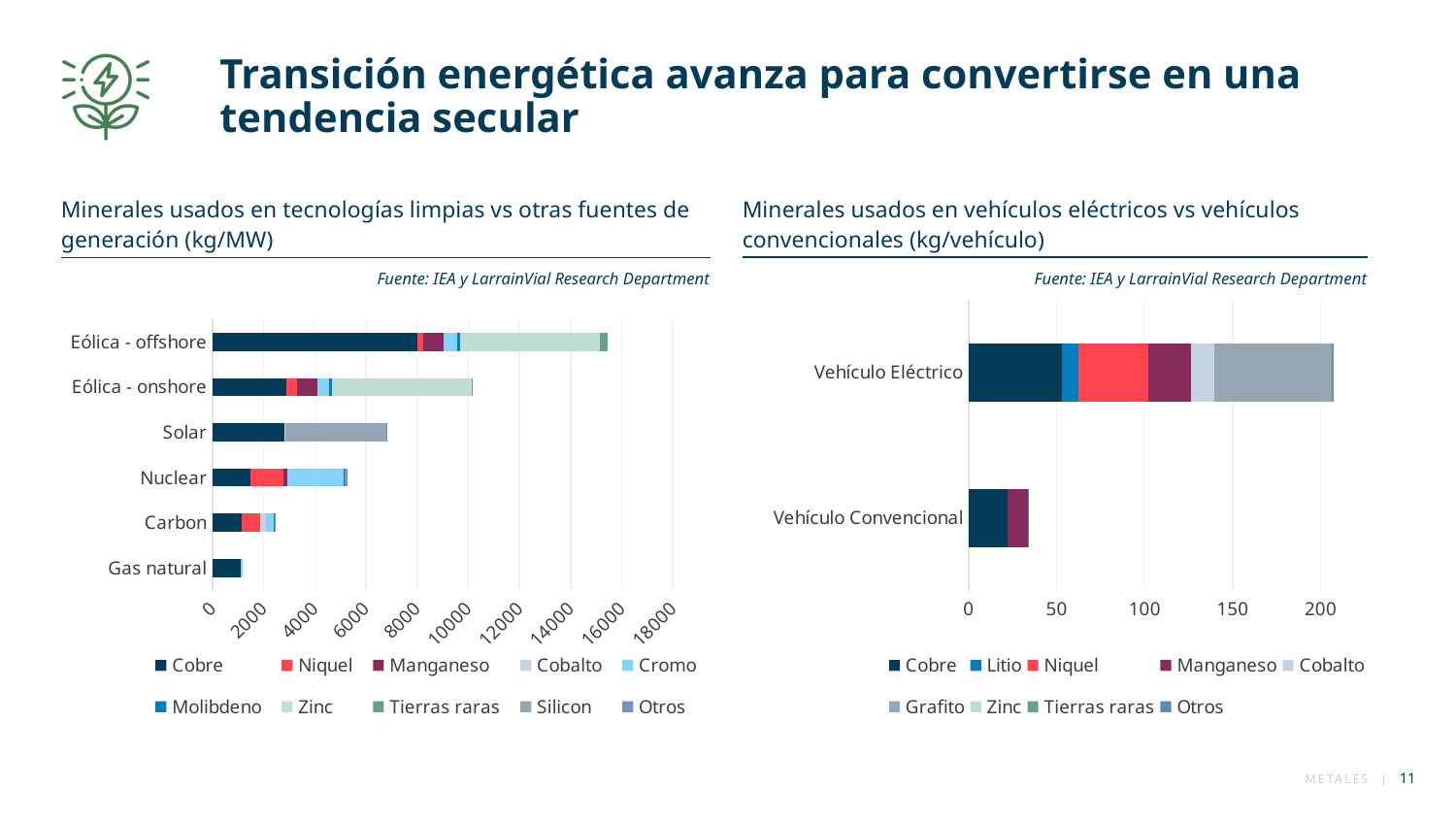
In the left chart (kg/MW), which generation technology has the largest total bar? Eólica - offshore What kind of chart is the left chart, 'Minerales usados en tecnologías limpias vs otras fuentes de generación (kg/MW)'? Stacked bar chart In the right chart (kg/vehículo), how many vehicle types are shown? 2 In the right chart (kg/vehículo), how many mineral series does the legend list? 9 In the left chart (kg/MW), is the total value for Eólica - offshore greater or less than 14000? greater In the left chart (kg/MW), is the total value for Solar greater or less than 8000? less In the right chart (kg/vehículo), is the total value for Vehículo Eléctrico greater or less than 150? greater In the left chart (kg/MW), which generation technology has the smallest total bar? Gas natural In the left chart (kg/MW), how many mineral series does the legend list? 10 In the left chart (kg/MW), how many generation technologies are shown on the vertical axis? 6 In the left chart (kg/MW), which has a larger total bar, Solar or Nuclear? Solar